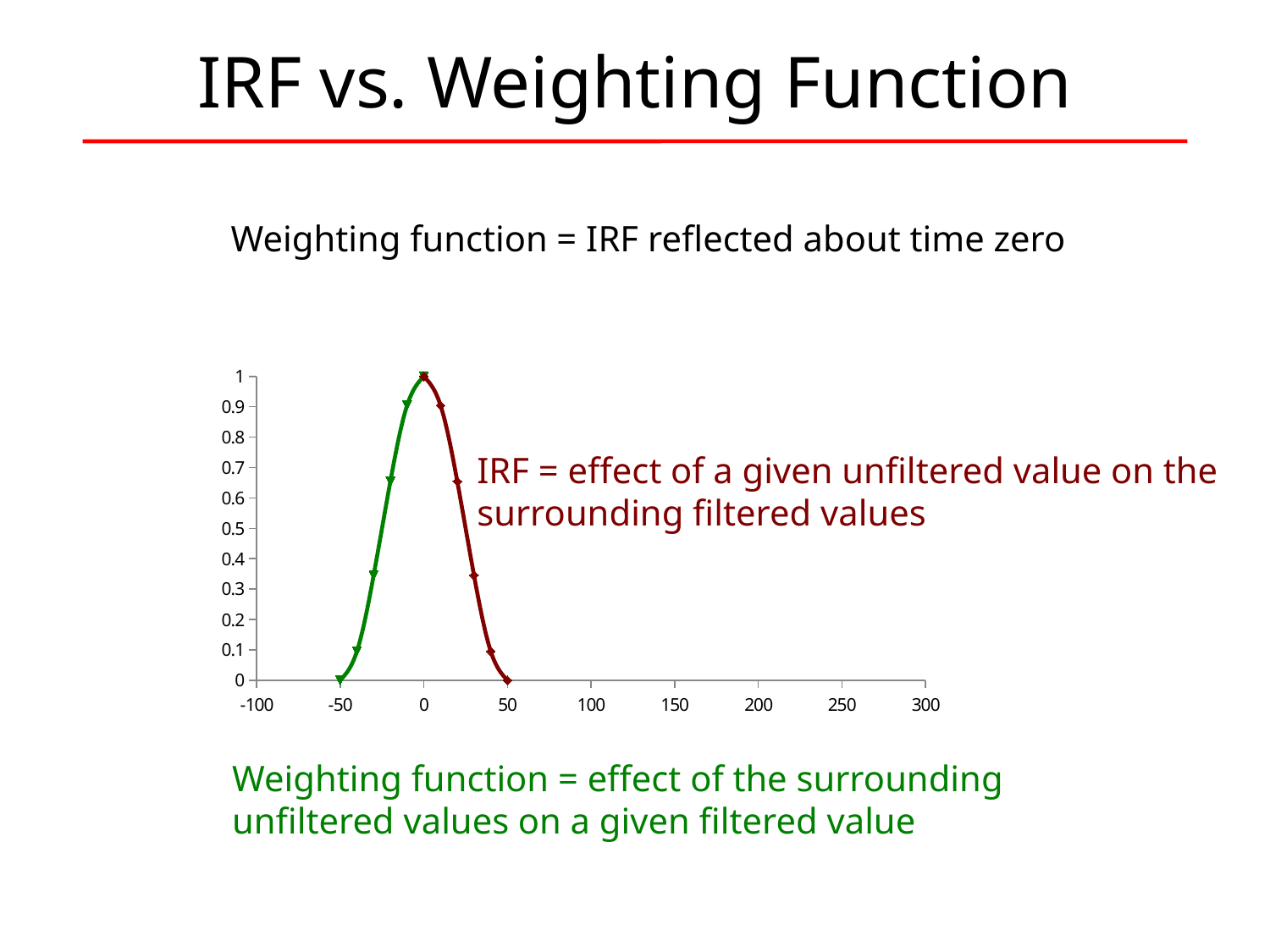
What kind of chart is shown on the slide? line chart Is the value of the dark red curve at x = 20 greater or less than 0.5? greater Does the dark red IRF curve rise or fall as x increases from 0 to 50? fall Is the value of the green curve at x = -40 greater or less than 0.2? less What colour is the IRF curve on the chart? dark red At which x value does the curve reach its highest point? 0 Which is larger, the value of the green curve at x = -40 or at x = -20? x = -20 How many marked data points are on the green weighting function curve? 6 What is the value of the curve at x = 0? 1 Is the value of the dark red curve at x = 10 greater or less than 0.8? greater What is the value of the dark red IRF curve at x = 50? 0 What is the value of the green weighting function curve at x = -50? 0